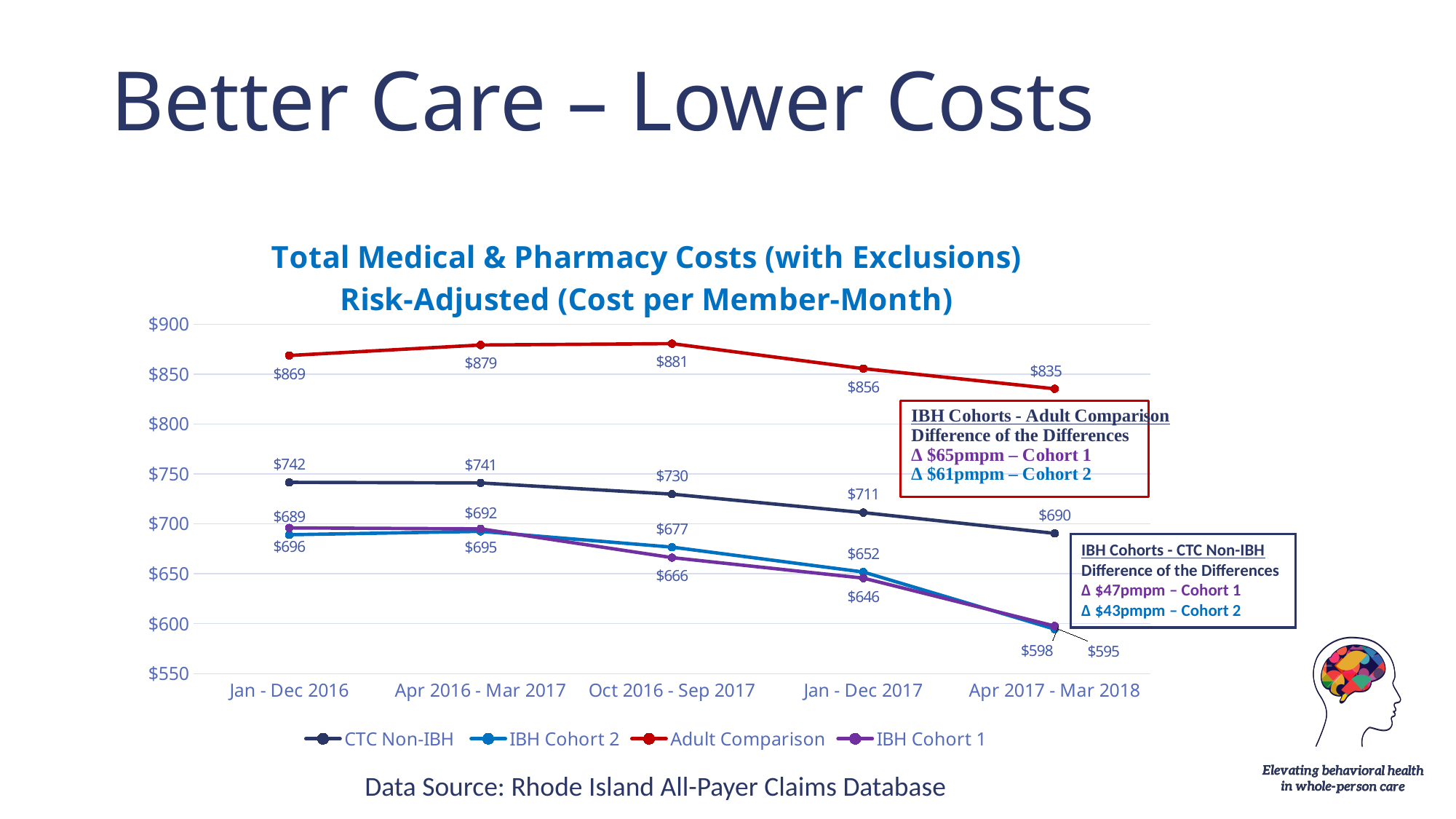
How many series does the legend list? 4 In which period is the Adult Comparison value highest? Oct 2016 - Sep 2017 What type of chart is shown on the slide? Line chart What is the IBH Cohort 2 value for Oct 2016 - Sep 2017? $677 Which is larger for Jan - Dec 2017: the Adult Comparison value or the CTC Non-IBH value? Adult Comparison What is the CTC Non-IBH value for Apr 2017 - Mar 2018? $690 Does the CTC Non-IBH series rise or fall from Jan - Dec 2016 to Apr 2017 - Mar 2018? Fall What is the difference between the Adult Comparison values for Jan - Dec 2016 and Apr 2017 - Mar 2018? $34 What is the title of the chart? Total Medical & Pharmacy Costs (with Exclusions) Risk-Adjusted (Cost per Member-Month) What is the Adult Comparison value for Oct 2016 - Sep 2017? $881 How many time periods are plotted along the x axis? 5 What is the IBH Cohort 1 value for Jan - Dec 2017? $646